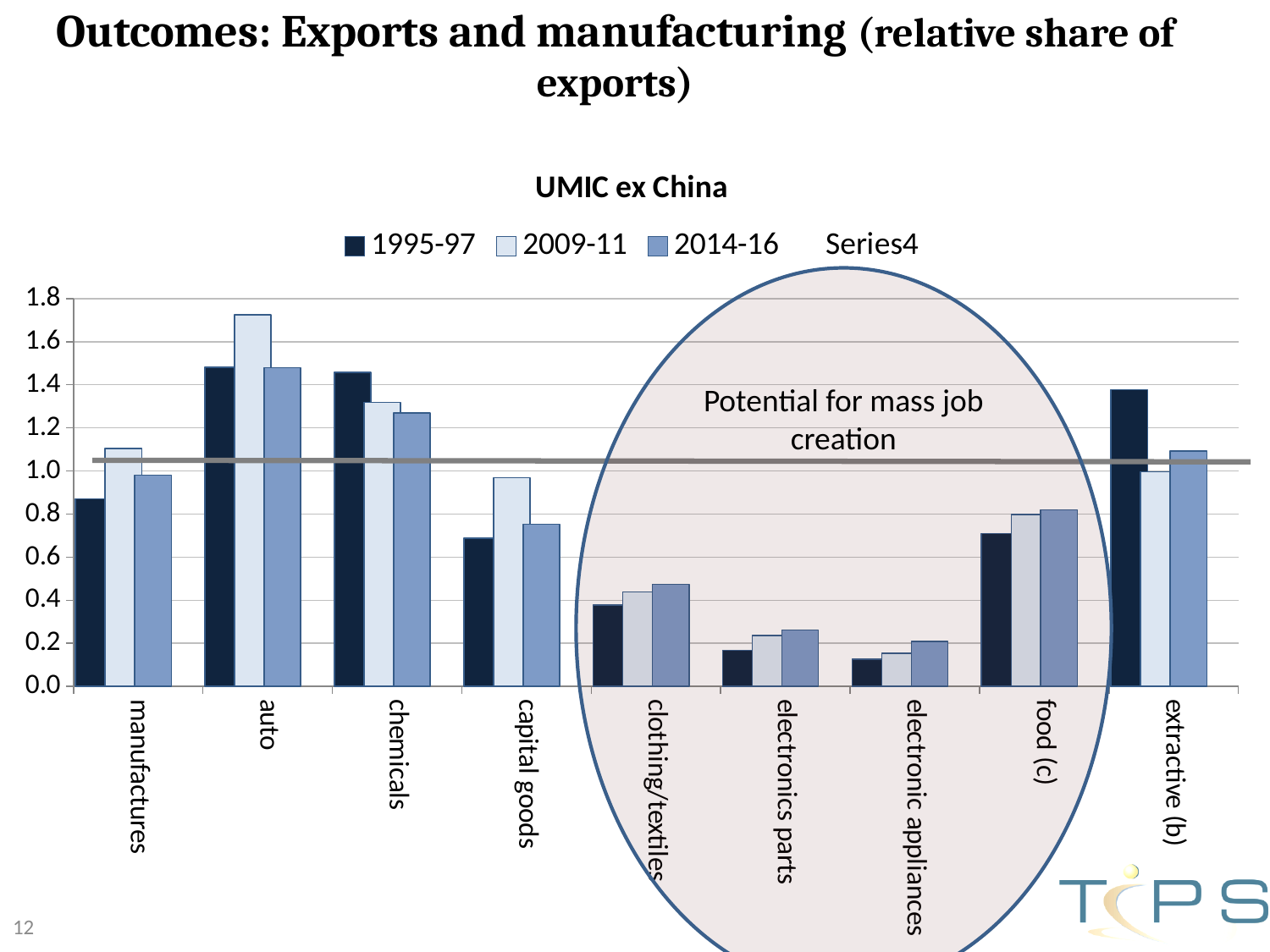
How many categories are shown along the x axis of the chart? 9 Is the 2014-16 value for electronics parts greater or less than 0.4? less Is the 1995-97 value for extractive (b) greater or less than 1.2? greater Is the 2009-11 value for auto greater or less than 1.6? greater For chemicals, do the values rise or fall from 1995-97 through 2014-16? fall What kind of chart is shown on the slide? bar chart What is the title of the chart? UMIC ex China How many series does the chart's legend list? 4 Which category has the highest value for the 2009-11 series? auto For the 2009-11 series, which is larger: manufactures or capital goods? manufactures For electronic appliances, do the values rise or fall from 1995-97 through 2014-16? rise Which category has the lowest value for the 1995-97 series? electronic appliances